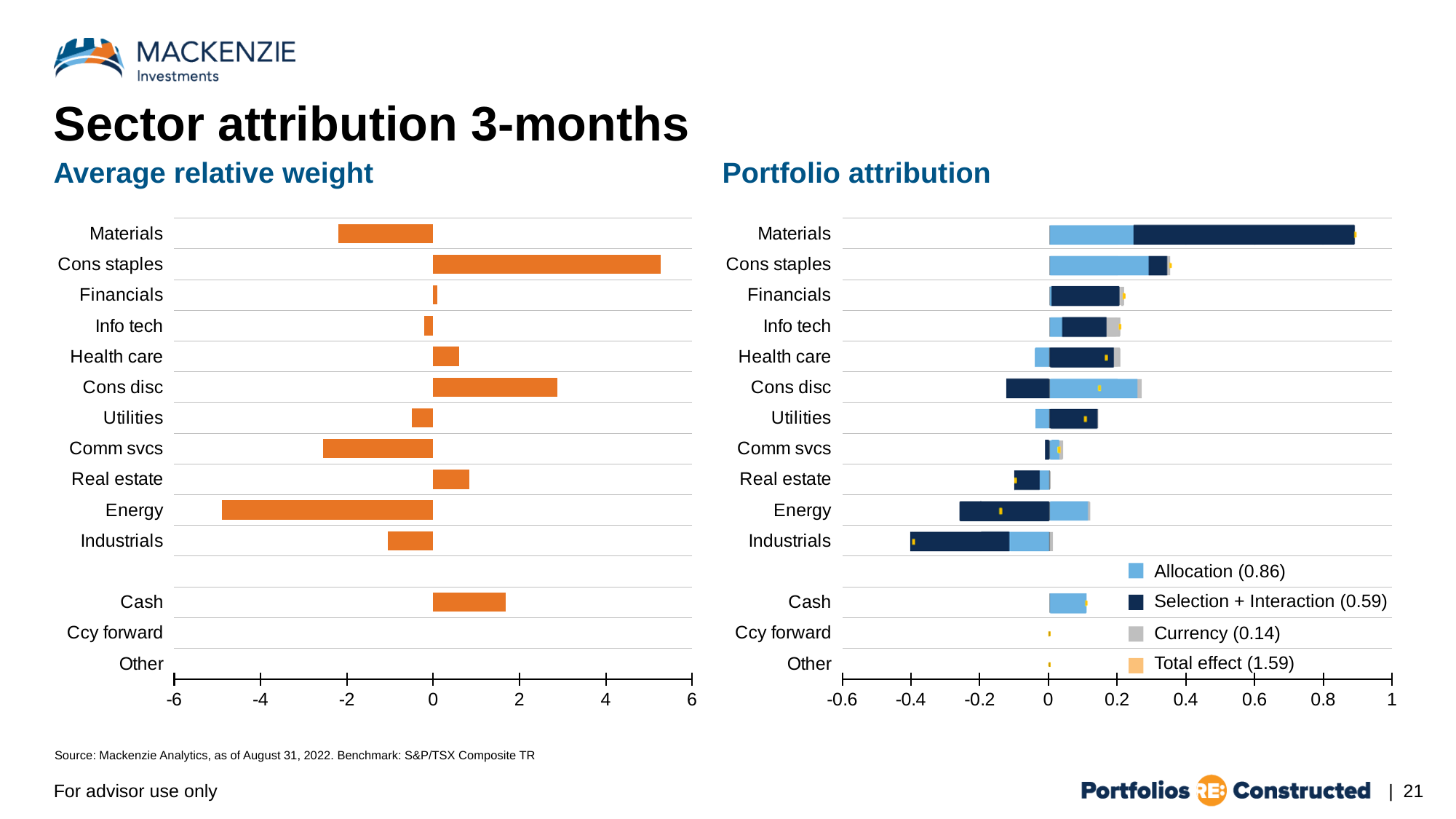
In the 'Average relative weight' chart, is the value for Energy greater or less than -4? less In the 'Average relative weight' chart, which sector has the lowest average relative weight? Energy In the 'Average relative weight' chart, which sector has the highest average relative weight? Cons staples In the 'Average relative weight' chart, is the value for Cons disc greater or less than 2? greater How many categories are listed on the y axis of the 'Average relative weight' chart? 14 In the 'Portfolio attribution' chart, what value is shown in parentheses next to 'Total effect' in the legend? 1.59 What kind of chart is the 'Average relative weight' chart? bar chart In the 'Average relative weight' chart, which is larger, the value for Cons staples or the value for Cons disc? Cons staples In the 'Portfolio attribution' chart, is the Total effect marker for Materials greater or less than 0.8? greater In the 'Portfolio attribution' chart, which sector has the largest positive Selection + Interaction contribution? Materials How many series does the legend of the 'Portfolio attribution' chart list? 4